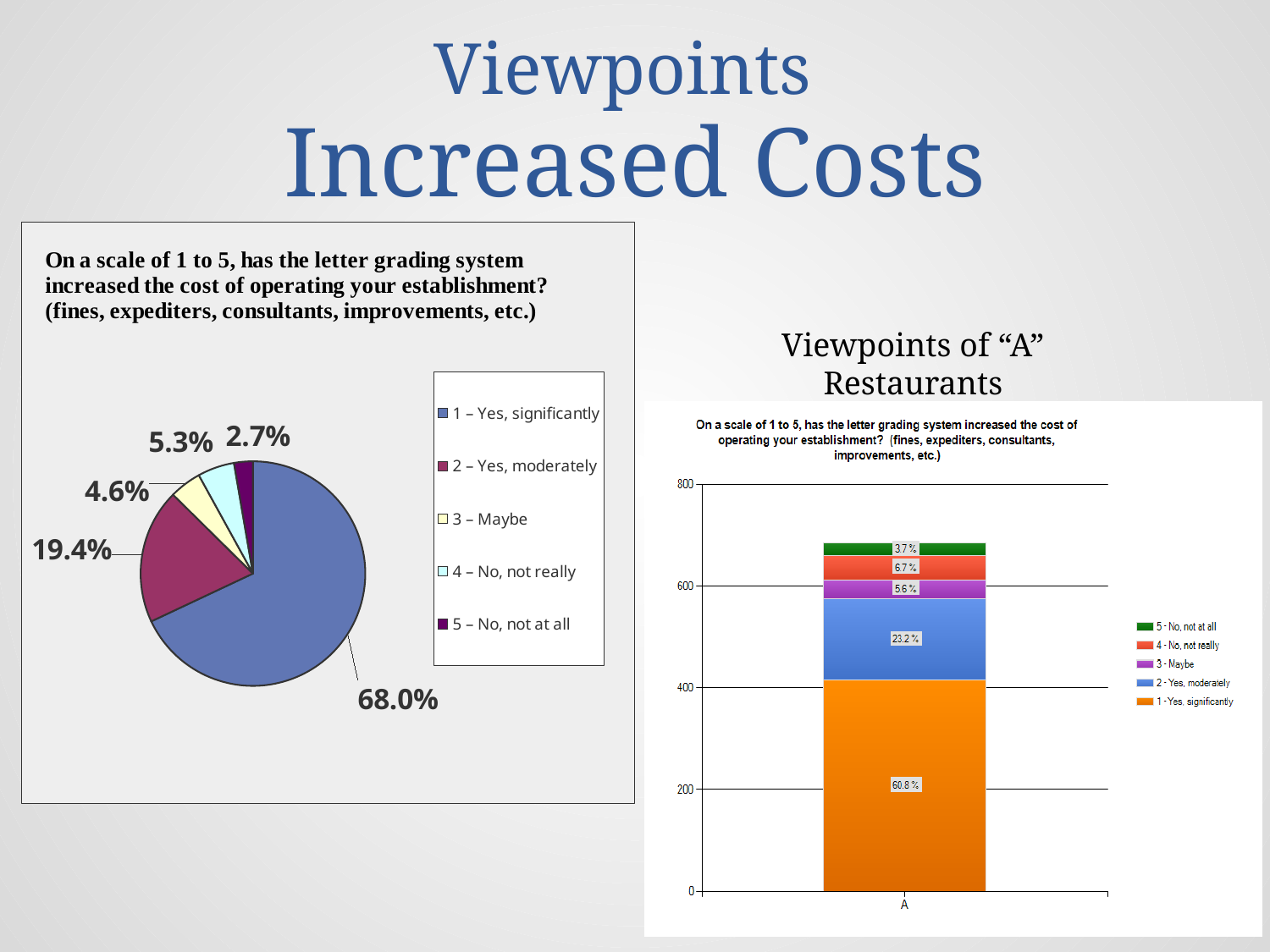
In the "Viewpoints of "A" Restaurants" chart on the right, what percentage is labelled for "1 - Yes, significantly"? 60.8 % In the "Viewpoints of "A" Restaurants" chart on the right, how many series does the legend list? 5 In the pie chart on the left, which response has the largest slice? 1 – Yes, significantly In the pie chart on the left, what share of respondents answered "2 – Yes, moderately"? 19.4% In the "Viewpoints of "A" Restaurants" chart on the right, is the total height of the stacked bar greater or less than 600? greater In the pie chart on the left, which is larger: the share for "4 – No, not really" or the share for "3 – Maybe"? 4 – No, not really In the pie chart on the left, how many slices does the pie have? 5 In the pie chart on the left, what is the difference between the shares for "1 – Yes, significantly" and "2 – Yes, moderately"? 48.6 percentage points In the pie chart on the left, which response has the smallest slice? 5 – No, not at all In the pie chart on the left, what share of respondents answered "1 – Yes, significantly"? 68.0% In the "Viewpoints of "A" Restaurants" chart on the right, what kind of chart is shown? Stacked bar chart In the "Viewpoints of "A" Restaurants" chart on the right, what percentage is labelled for "2 - Yes, moderately"? 23.2 %